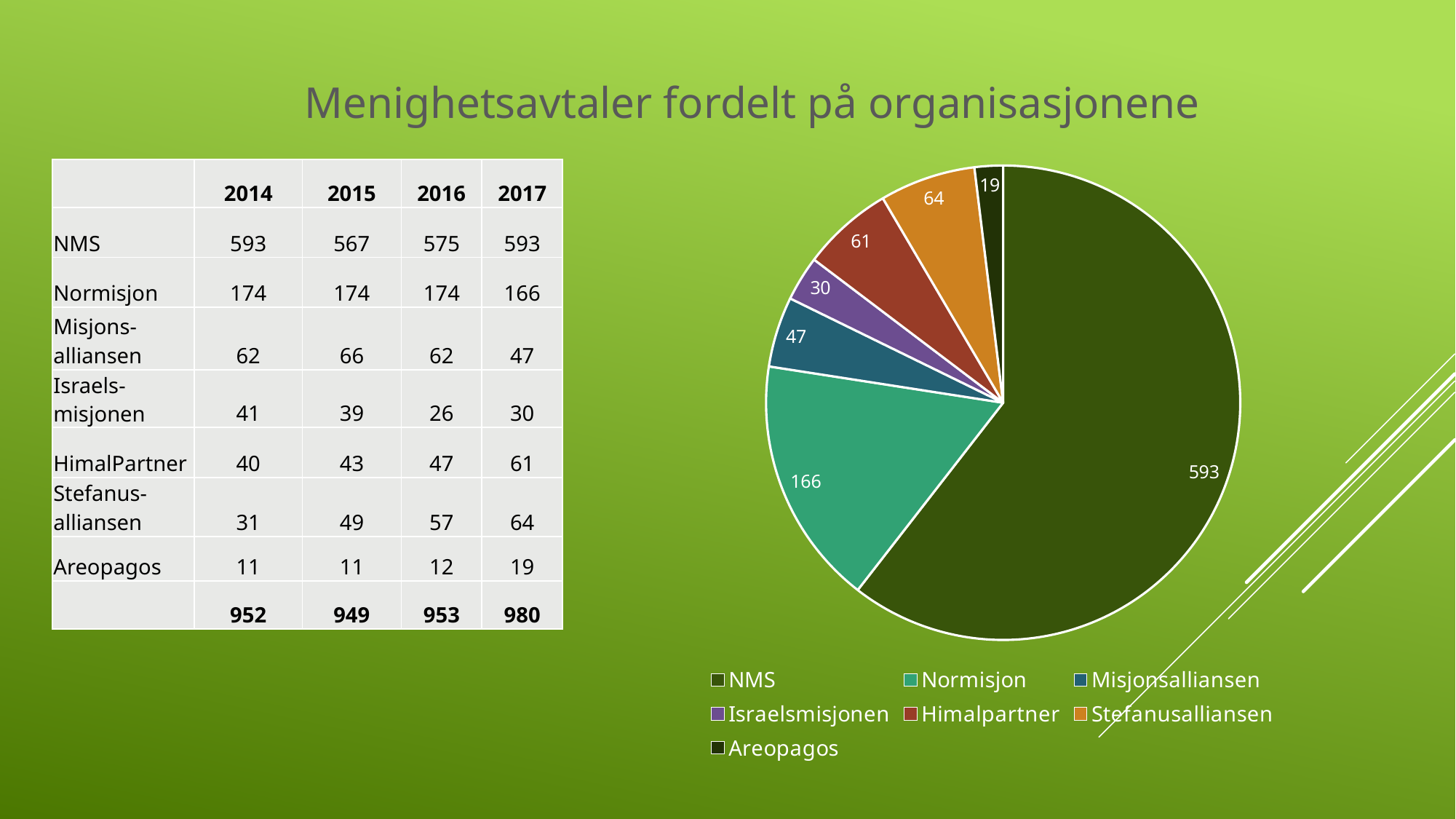
What is the total of all the values shown in the pie chart? 980 In the pie chart, what is the difference between the values for NMS and Normisjon? 427 How many slices does the pie chart have? 7 In the pie chart, what is the value for Israelsmisjonen? 30 How many entries does the pie chart's legend list? 7 Which organisation has the smallest slice in the pie chart? Areopagos In the pie chart, what is the value for Stefanusalliansen? 64 In the pie chart, which is larger: the value for Himalpartner or the value for Misjonsalliansen? Himalpartner In the pie chart, what is the value for NMS? 593 What type of chart is shown on the slide? pie chart In the pie chart, what is the value for Normisjon? 166 Which organisation has the largest slice in the pie chart? NMS